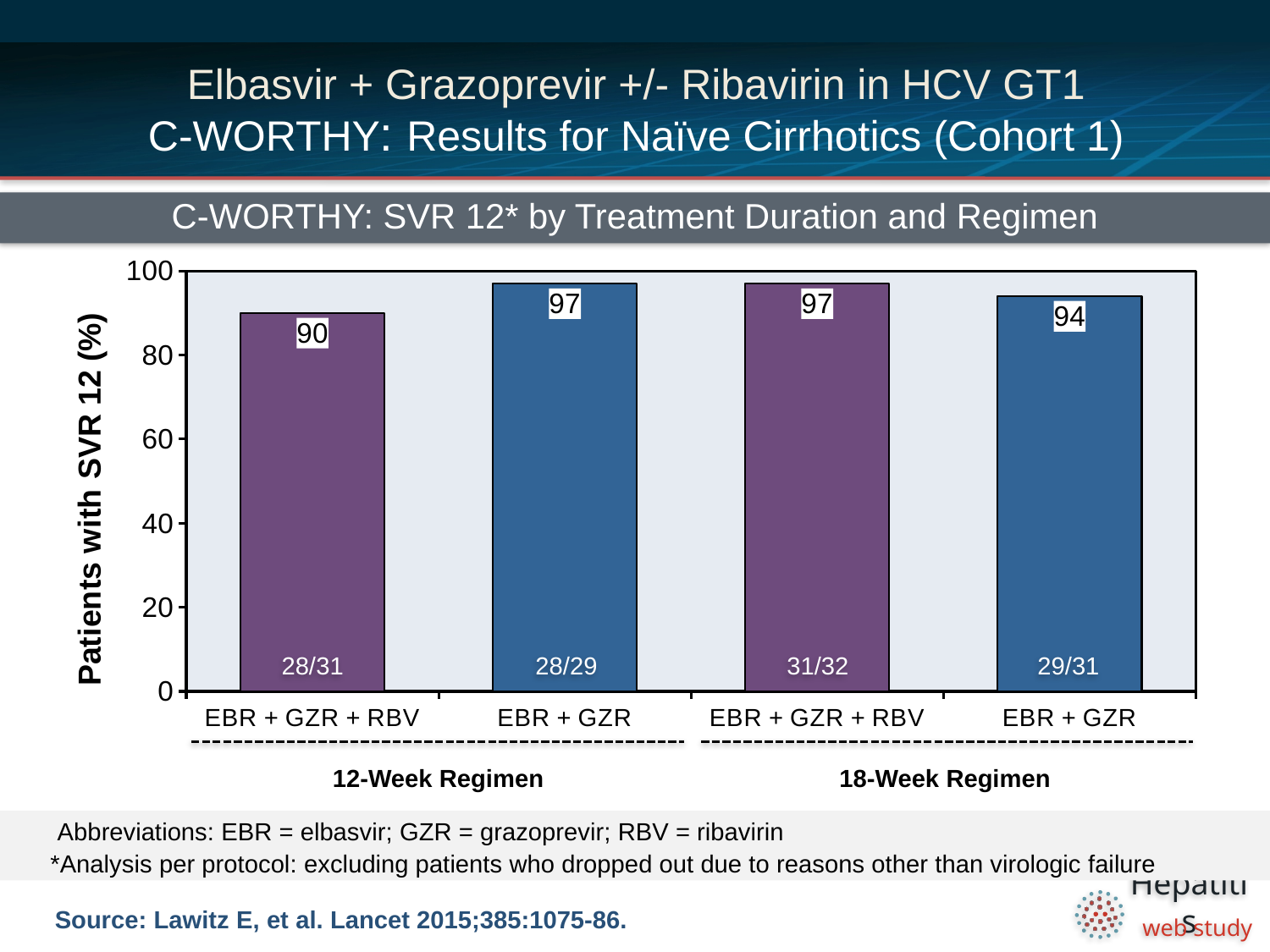
What is the label of the y-axis? Patients with SVR 12 (%) What is the SVR 12 value for EBR + GZR + RBV in the 12-Week Regimen? 90 What is the SVR 12 value for EBR + GZR in the 18-Week Regimen? 94 What kind of chart is shown on the slide? bar chart What is the difference between the SVR 12 values for EBR + GZR and EBR + GZR + RBV in the 12-Week Regimen? 7 How many bars are plotted in the chart? 4 Which bar has the lowest SVR 12 value? EBR + GZR + RBV (12-Week Regimen) Is the SVR 12 value for EBR + GZR + RBV in the 12-Week Regimen greater or less than 80? greater What fraction of patients is shown for EBR + GZR + RBV in the 18-Week Regimen? 31/32 What is the title of the chart? C-WORTHY: SVR 12* by Treatment Duration and Regimen Which is larger: the SVR 12 value for EBR + GZR + RBV in the 18-Week Regimen or for EBR + GZR in the 18-Week Regimen? EBR + GZR + RBV (18-Week Regimen) What is the SVR 12 value for EBR + GZR in the 12-Week Regimen? 97